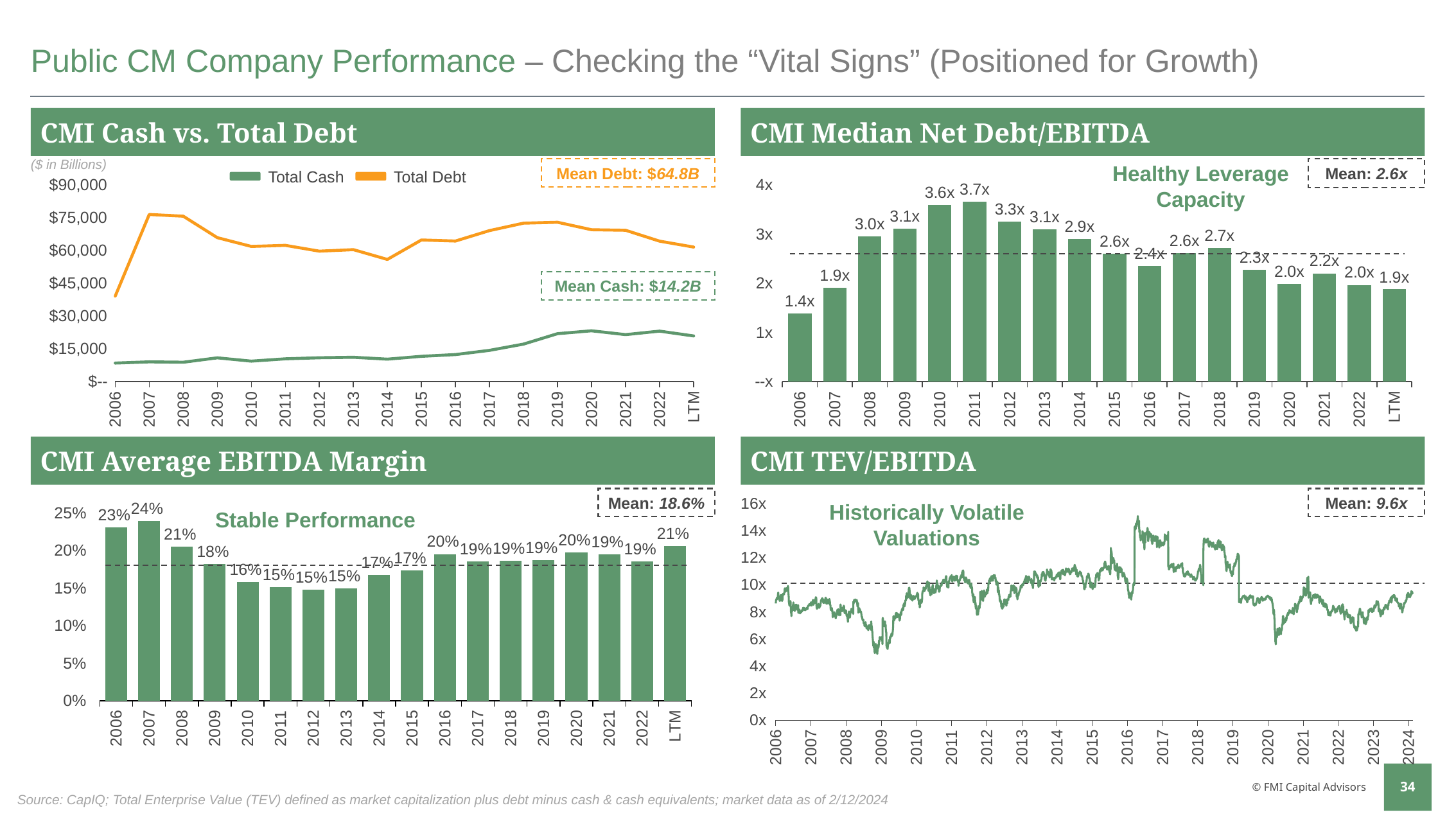
How many bars are plotted in the CMI Average EBITDA Margin chart? 18 In the CMI Median Net Debt/EBITDA chart, what is the value for 2011? 3.7x In the CMI Median Net Debt/EBITDA chart, which year has the highest value? 2011 In the CMI Average EBITDA Margin chart, what is the value for 2007? 24% In the CMI Median Net Debt/EBITDA chart, which year has the lowest value? 2006 In the CMI Median Net Debt/EBITDA chart, what is the difference between the 2011 value and the LTM value? 1.8x In the CMI Average EBITDA Margin chart, which year has the highest margin? 2007 In the CMI Cash vs. Total Debt chart, is the Total Debt value for 2007 greater or less than $60,000? greater In the CMI TEV/EBITDA chart, what mean value is shown in the box? 9.6x In the CMI Average EBITDA Margin chart, which is larger, the value for 2016 or the value for 2019? 2016 What kind of chart is the CMI Cash vs. Total Debt chart? Line chart How many series does the legend of the CMI Cash vs. Total Debt chart list? 2